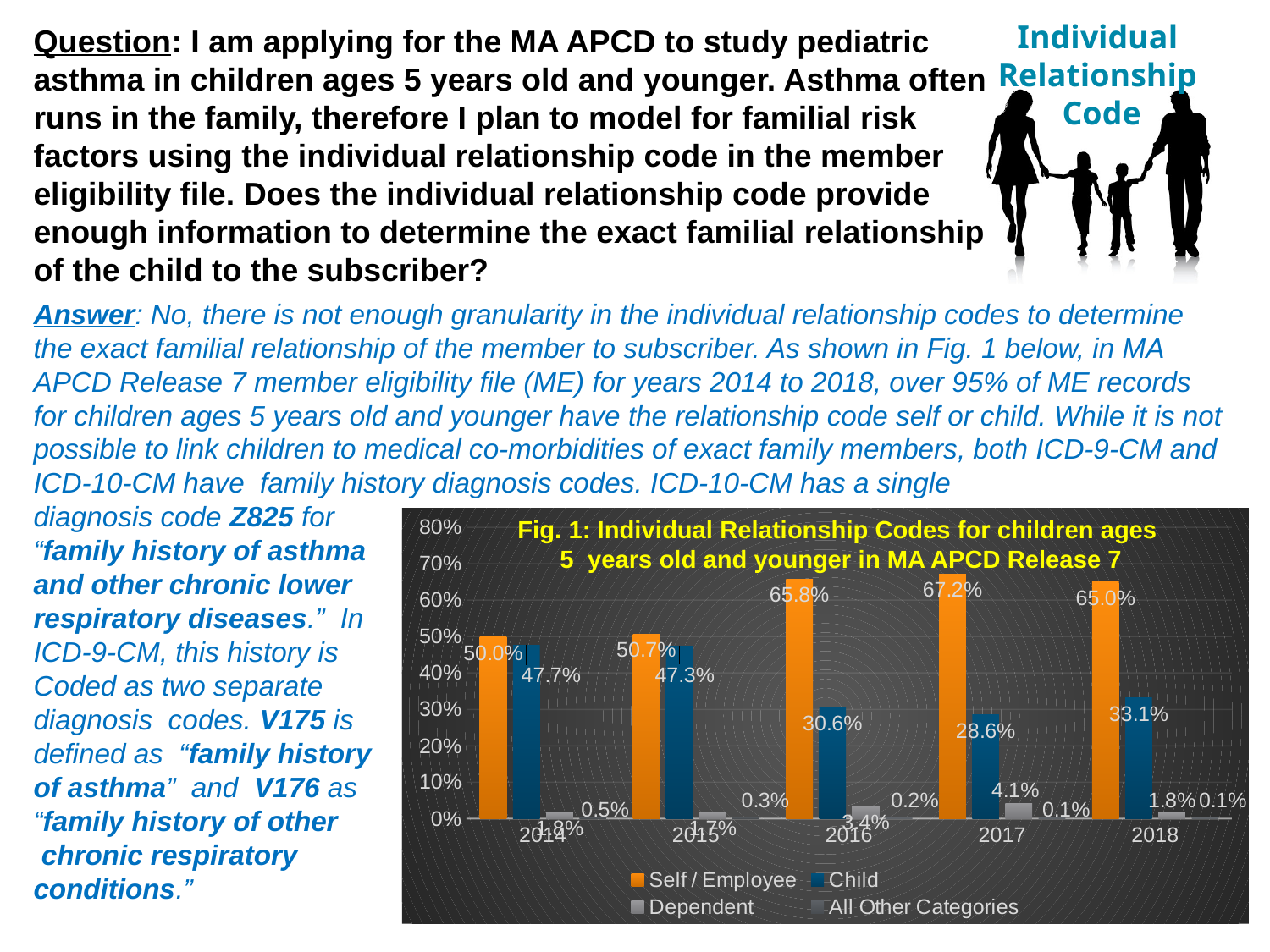
What is the difference between the Self / Employee and Child values in 2018? 31.9% What is the value for Self / Employee in 2017? 67.2% How many years are shown on the x axis? 5 In which year is the Child value lowest? 2017 What kind of chart is Fig. 1? Bar chart Which is larger in 2014, Self / Employee or Child? Self / Employee How many series does the legend list? 4 What is the value for Child in 2016? 30.6% In which year is the Self / Employee value highest? 2017 What is the value for All Other Categories in 2014? 0.5% What is the value for Dependent in 2017? 4.1% Which series is shown in orange? Self / Employee